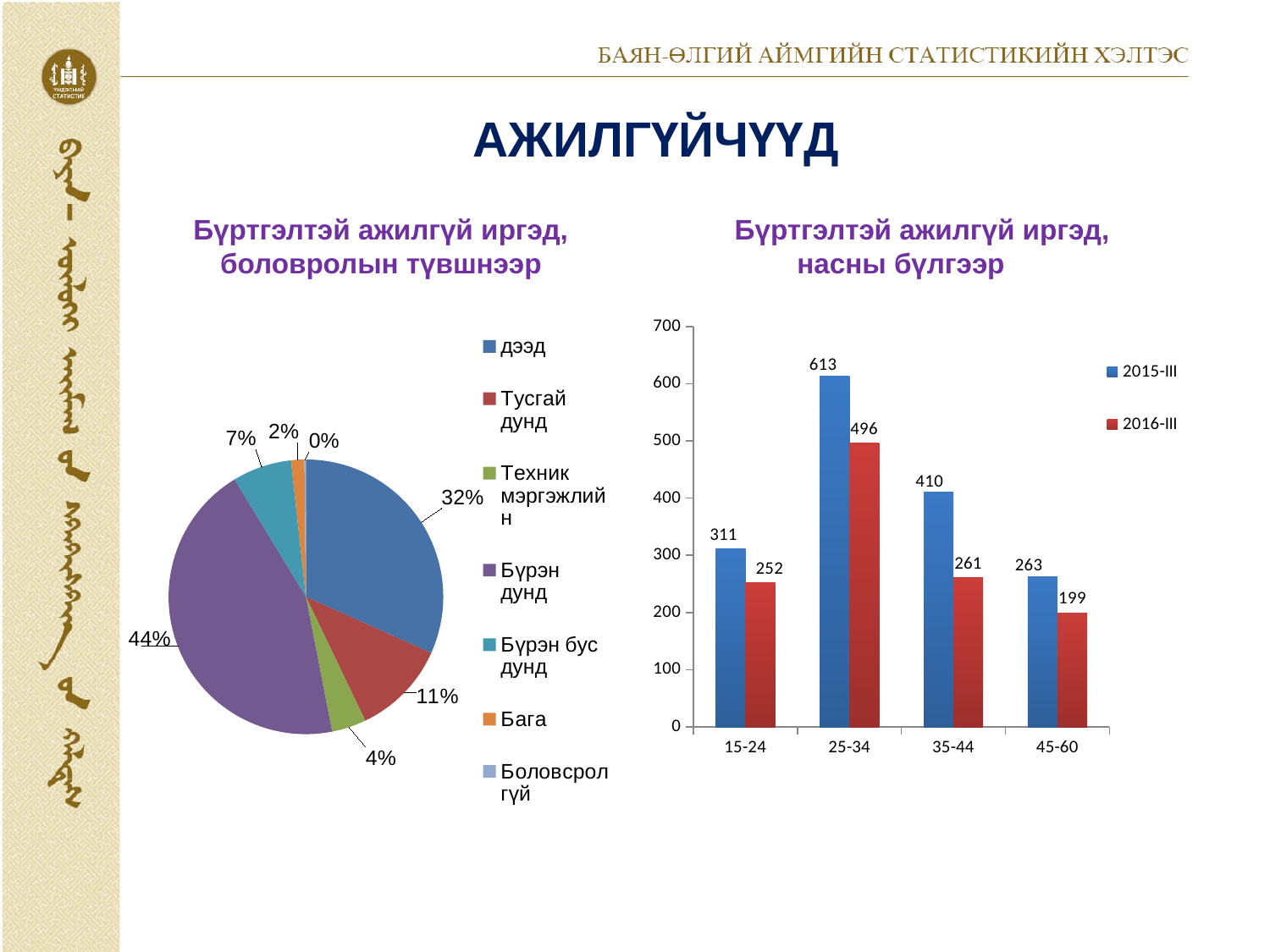
In the bar chart 'Бүртгэлтэй ажилгүй иргэд, насны бүлгээр', how many age groups are shown on the x axis? 4 In the bar chart 'Бүртгэлтэй ажилгүй иргэд, насны бүлгээр', which age group has the lowest value in 2015-III? 45-60 In the bar chart 'Бүртгэлтэй ажилгүй иргэд, насны бүлгээр', what is the value for 45-60 in 2016-III? 199 In the bar chart 'Бүртгэлтэй ажилгүй иргэд, насны бүлгээр', what is the value for 25-34 in 2015-III? 613 In the pie chart 'Бүртгэлтэй ажилгүй иргэд, боловролын түвшнээр', what share does 'Бүрэн дунд' have? 44% In the bar chart 'Бүртгэлтэй ажилгүй иргэд, насны бүлгээр', what is the difference between the 2015-III and 2016-III values for 35-44? 149 In the bar chart 'Бүртгэлтэй ажилгүй иргэд, насны бүлгээр', how many series does the legend list? 2 In the pie chart 'Бүртгэлтэй ажилгүй иргэд, боловролын түвшнээр', which category has the largest share? Бүрэн дунд In the bar chart 'Бүртгэлтэй ажилгүй иргэд, насны бүлгээр', which is larger: the 2016-III value for 15-24 or the 2015-III value for 45-60? 2015-III value for 45-60 In the pie chart 'Бүртгэлтэй ажилгүй иргэд, боловролын түвшнээр', what share does 'Тусгай дунд' have? 11% In the bar chart 'Бүртгэлтэй ажилгүй иргэд, насны бүлгээр', which age group has the highest value in 2016-III? 25-34 What type of chart is the chart on the left of the slide? Pie chart